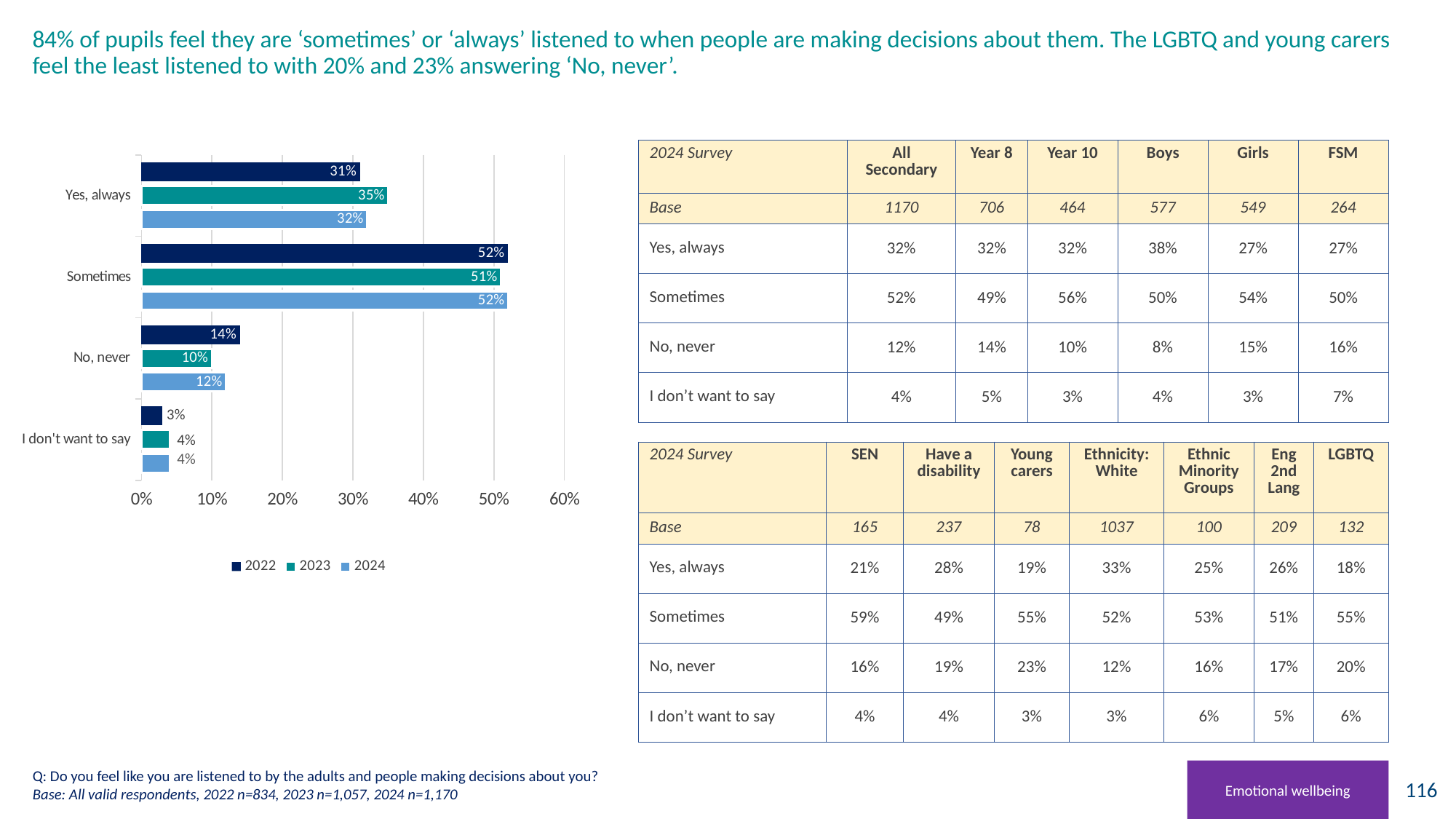
How many response categories are shown on the bar chart? 4 What is the 2022 value for 'Sometimes' in the bar chart? 52% What is the 2024 value for 'I don't want to say' in the bar chart? 4% What is the difference between the 2023 and 2022 values for 'Yes, always' in the bar chart? 4% Which is larger in the bar chart: the 2022 value for 'No, never' or the 2024 value for 'No, never'? 2022 Which years are listed in the legend of the bar chart? 2022, 2023, 2024 Which response category has the highest value for 2024 in the bar chart? Sometimes What kind of chart is shown on the slide? Bar chart What is the 2024 value for 'Yes, always' in the bar chart? 32% Which response category has the lowest value for 2022 in the bar chart? I don't want to say What is the 2023 value for 'No, never' in the bar chart? 10% How many series does the legend of the bar chart list? 3